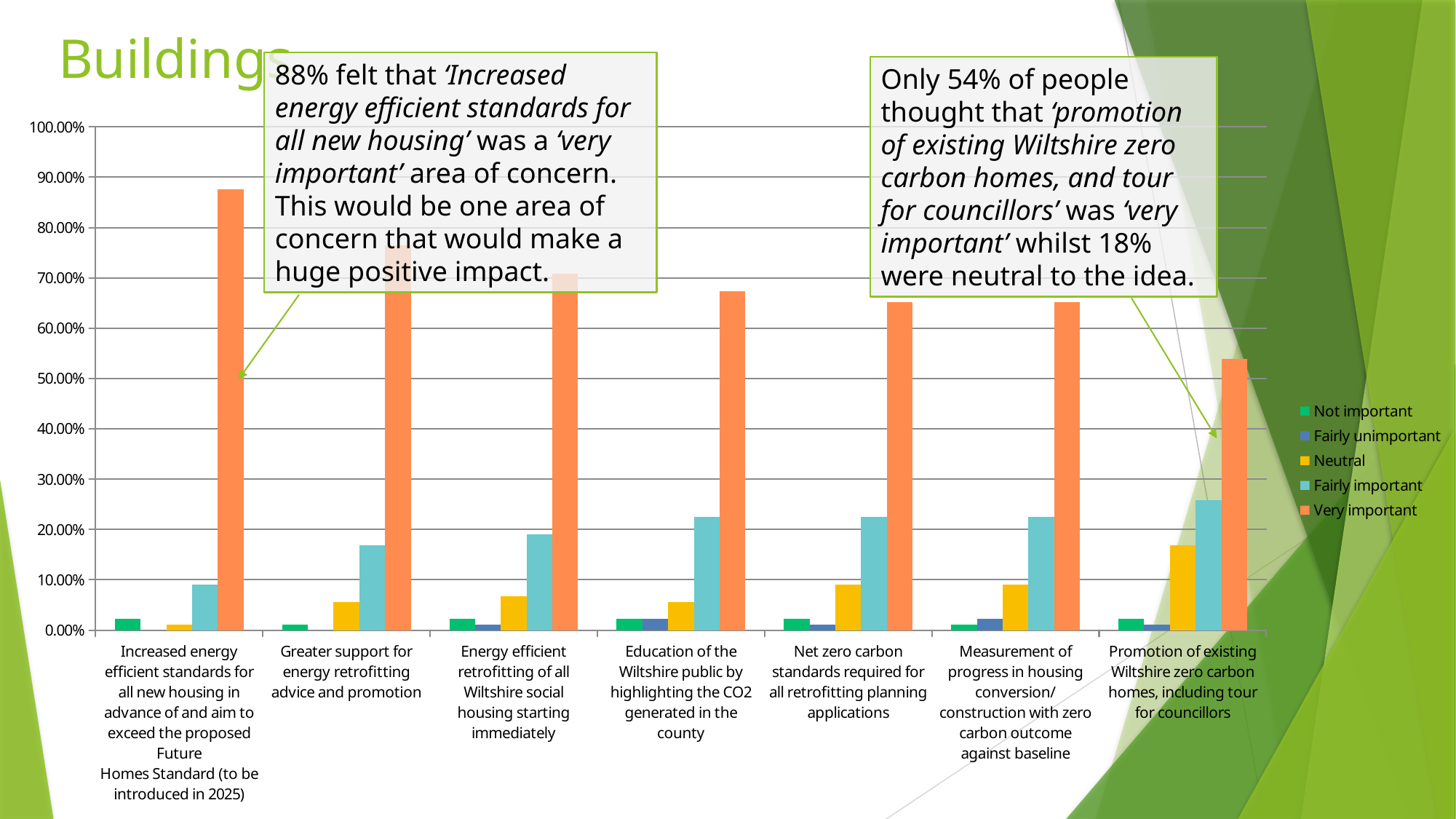
How many categories are shown along the x axis of the chart? 7 Is the 'Neutral' value for 'Promotion of existing Wiltshire zero carbon homes, including tour for councillors' greater or less than 10.00%? greater Is the 'Very important' value for 'Education of the Wiltshire public by highlighting the CO2 generated in the county' greater or less than 70.00%? less Which category has the highest 'Very important' value? Increased energy efficient standards for all new housing in advance of and aim to exceed the proposed Future Homes Standard (to be introduced in 2025) Which colour represents the 'Very important' series in the legend? orange Which category has the highest 'Fairly important' value? Promotion of existing Wiltshire zero carbon homes, including tour for councillors Which category has the lowest 'Very important' value? Promotion of existing Wiltshire zero carbon homes, including tour for councillors Which is larger: the 'Very important' value for 'Greater support for energy retrofitting advice and promotion' or for 'Energy efficient retrofitting of all Wiltshire social housing starting immediately'? Greater support for energy retrofitting advice and promotion What kind of chart is shown on the slide? bar chart Is the 'Very important' value for 'Promotion of existing Wiltshire zero carbon homes, including tour for councillors' greater or less than 60.00%? less How many series does the chart's legend list? 5